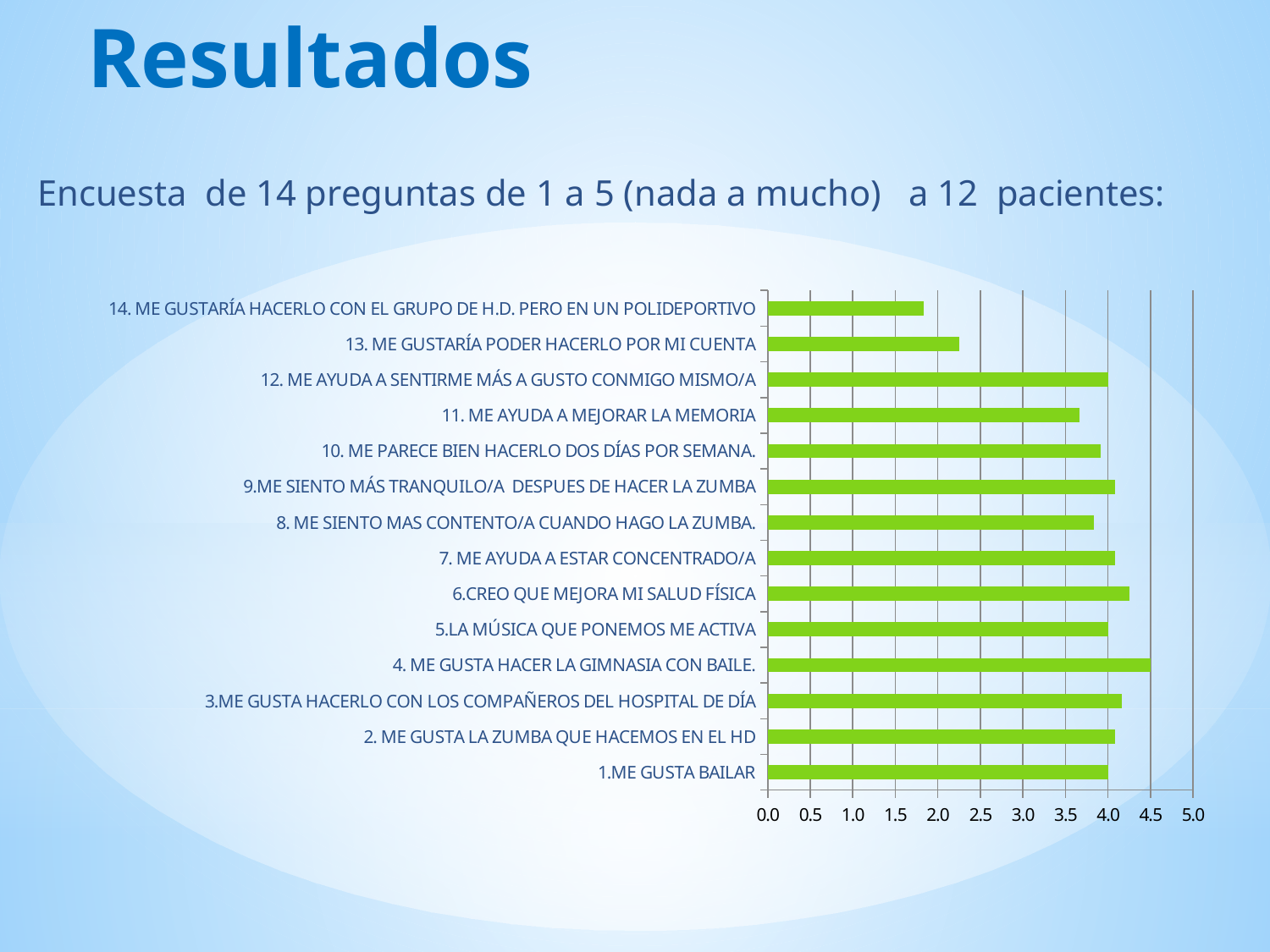
How many categories (questions) are plotted in the chart? 14 Is the value for "13. ME GUSTARÍA PODER HACERLO POR MI CUENTA" greater or less than 2.0? greater Which category has the highest value in the chart? 4. ME GUSTA HACER LA GIMNASIA CON BAILE. Is the value for "6.CREO QUE MEJORA MI SALUD FÍSICA" greater or less than 4.0? greater What colour are the bars in the chart? green What kind of chart is shown on the slide? bar chart Which has a larger value: "13. ME GUSTARÍA PODER HACERLO POR MI CUENTA" or "14. ME GUSTARÍA HACERLO CON EL GRUPO DE H.D. PERO EN UN POLIDEPORTIVO"? 13. ME GUSTARÍA PODER HACERLO POR MI CUENTA Which has a larger value: "6.CREO QUE MEJORA MI SALUD FÍSICA" or "11. ME AYUDA A MEJORAR LA MEMORIA"? 6.CREO QUE MEJORA MI SALUD FÍSICA Is the value for "14. ME GUSTARÍA HACERLO CON EL GRUPO DE H.D. PERO EN UN POLIDEPORTIVO" greater or less than 2.0? less Which category has the lowest value in the chart? 14. ME GUSTARÍA HACERLO CON EL GRUPO DE H.D. PERO EN UN POLIDEPORTIVO What is the maximum value shown on the horizontal axis of the chart? 5.0